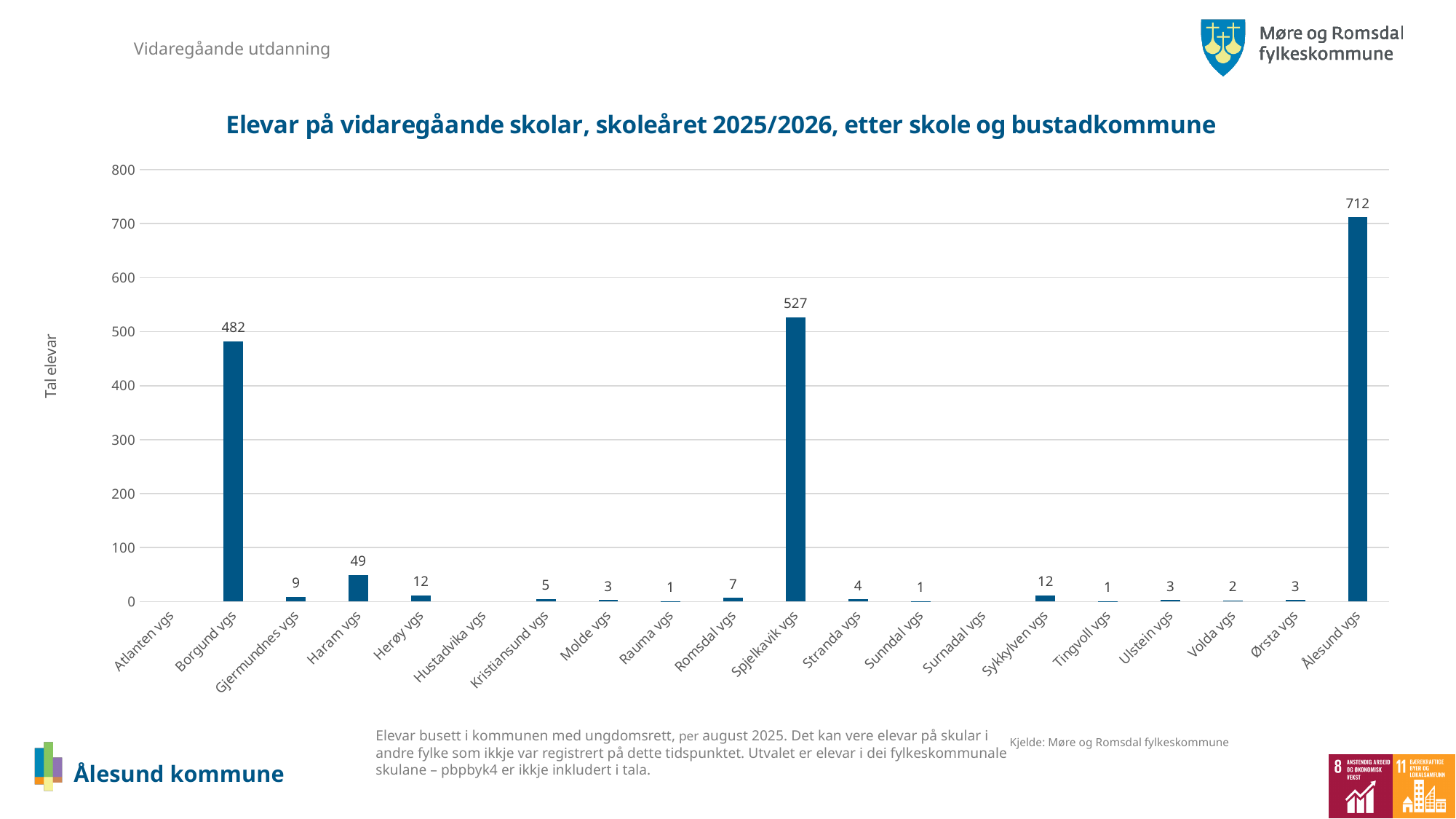
How many students are shown for Ålesund vgs? 712 Is the value for Borgund vgs greater or less than 500? less How many students are shown for Haram vgs? 49 Which is larger, the value for Borgund vgs or Spjelkavik vgs? Spjelkavik vgs Which school has the highest number of students? Ålesund vgs What is the value for Borgund vgs? 482 What is the difference between the values for Ålesund vgs and Spjelkavik vgs? 185 What kind of chart is shown on the slide? Bar chart What is the difference between the values for Spjelkavik vgs and Borgund vgs? 45 What is the value for Spjelkavik vgs? 527 How many schools are listed along the x axis? 20 What is the label of the vertical axis? Tal elevar